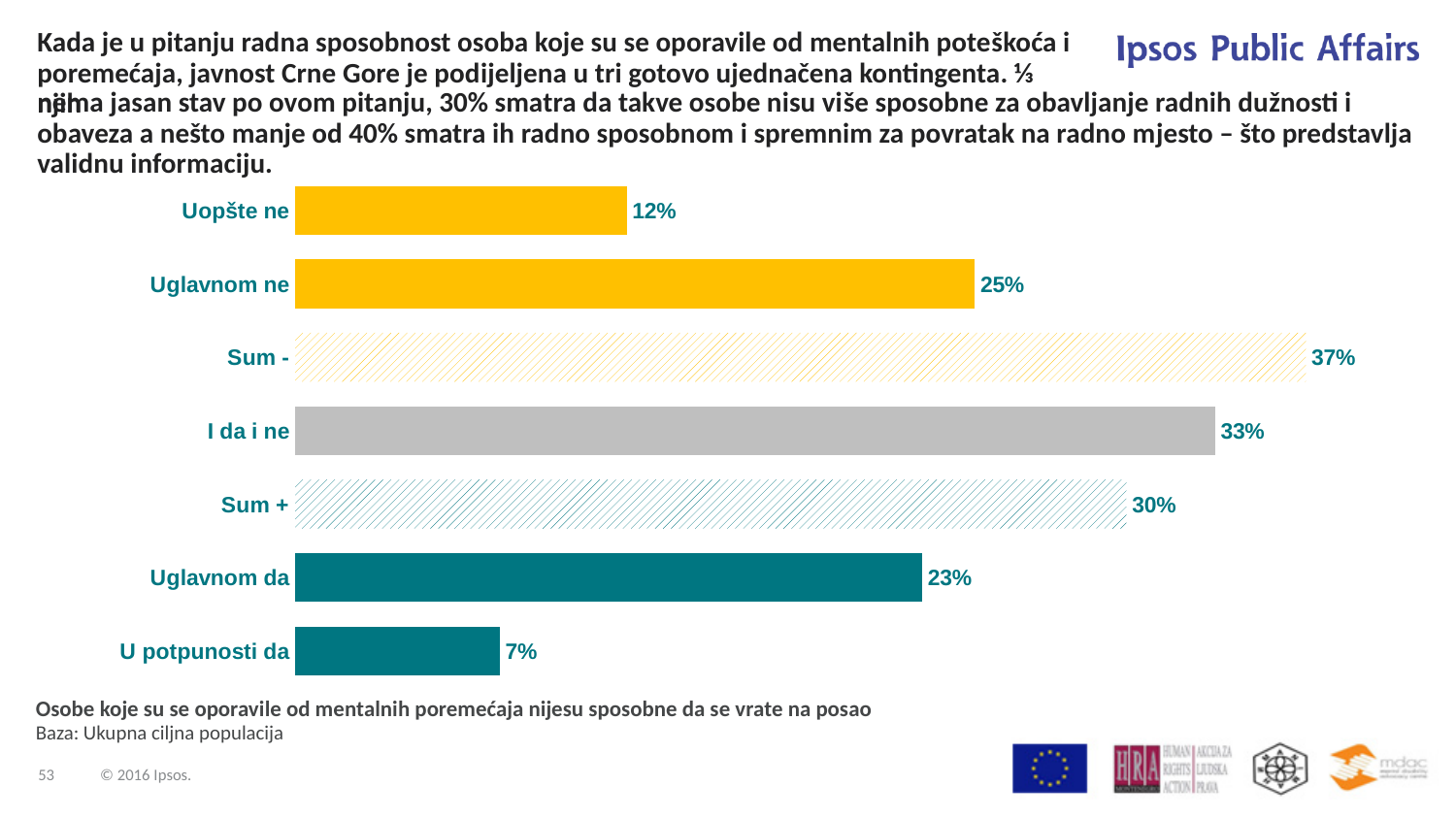
What is the value for "U potpunosti da"? 7% What is the difference between "Sum -" and "Sum +"? 7% What is the statement shown below the chart that respondents were asked about? Osobe koje su se oporavile od mentalnih poremećaja nijesu sposobne da se vrate na posao What is the value for "I da i ne"? 33% Which category has the highest value? Sum - What kind of chart is shown on the slide? Bar chart What is the difference between "Uglavnom ne" and "Uopšte ne"? 13% Which category has the lowest value? U potpunosti da What is the value for "Uglavnom ne"? 25% What is the value for "Sum +"? 30% Which is larger, "Uglavnom da" or "Uglavnom ne"? Uglavnom ne How many categories are shown in the chart? 7